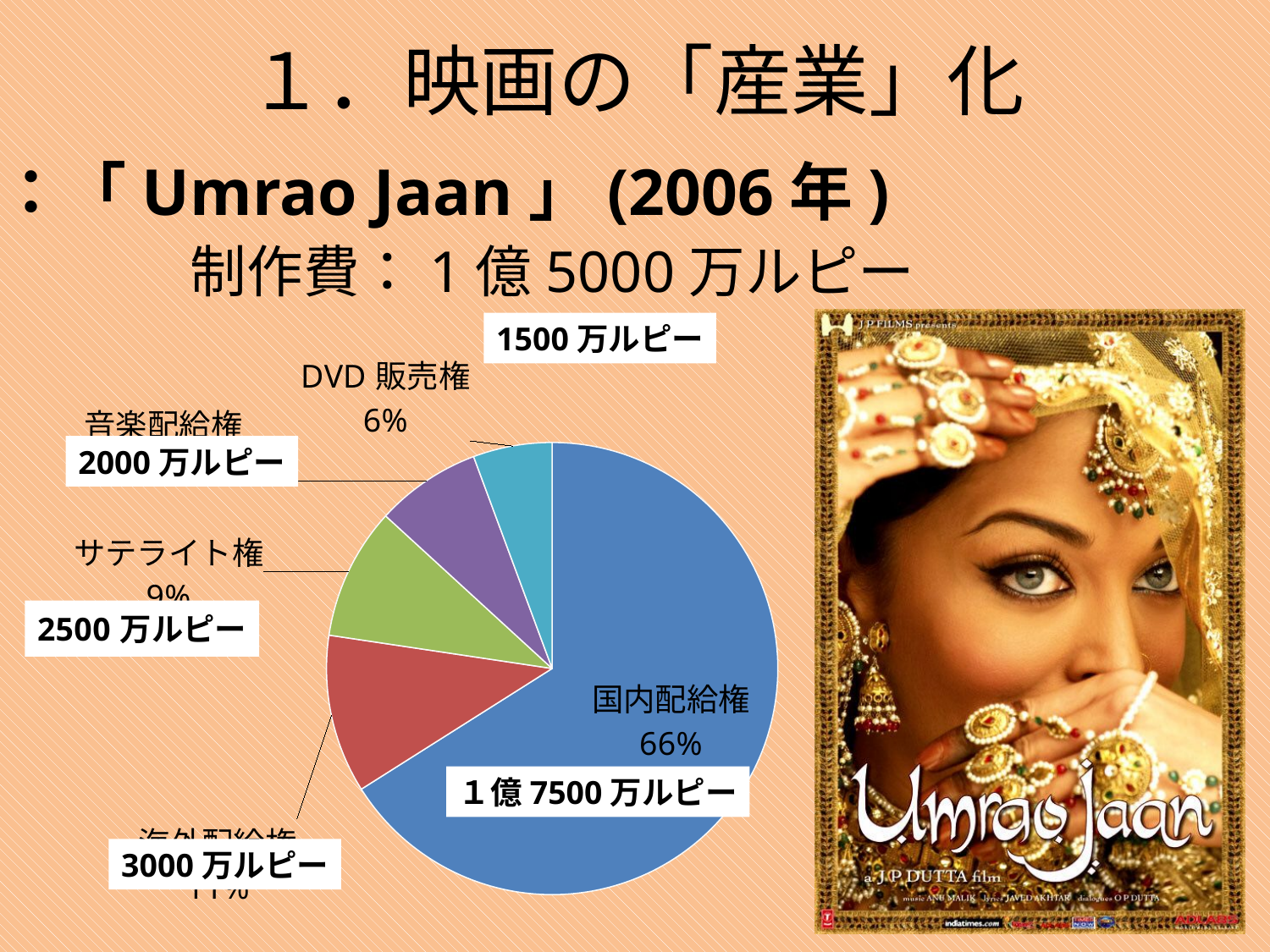
What share of the pie does DVD販売権 account for? 6% Which category has the smallest slice of the pie? DVD販売権 What is the difference in percentage points between the 国内配給権 slice and the DVD販売権 slice? 60% Which slice is larger, サテライト権 or DVD販売権? サテライト権 What rupee amount is labelled for DVD販売権? 1500万ルピー What colour is the 国内配給権 slice of the pie? blue Is the share for 国内配給権 greater or less than 50%? greater What rupee amount is labelled for 国内配給権? 1億7500万ルピー How many slices does the pie chart have? 5 What kind of chart is shown on the slide? pie chart Which category has the largest slice of the pie? 国内配給権 What share of the pie does 国内配給権 account for? 66%